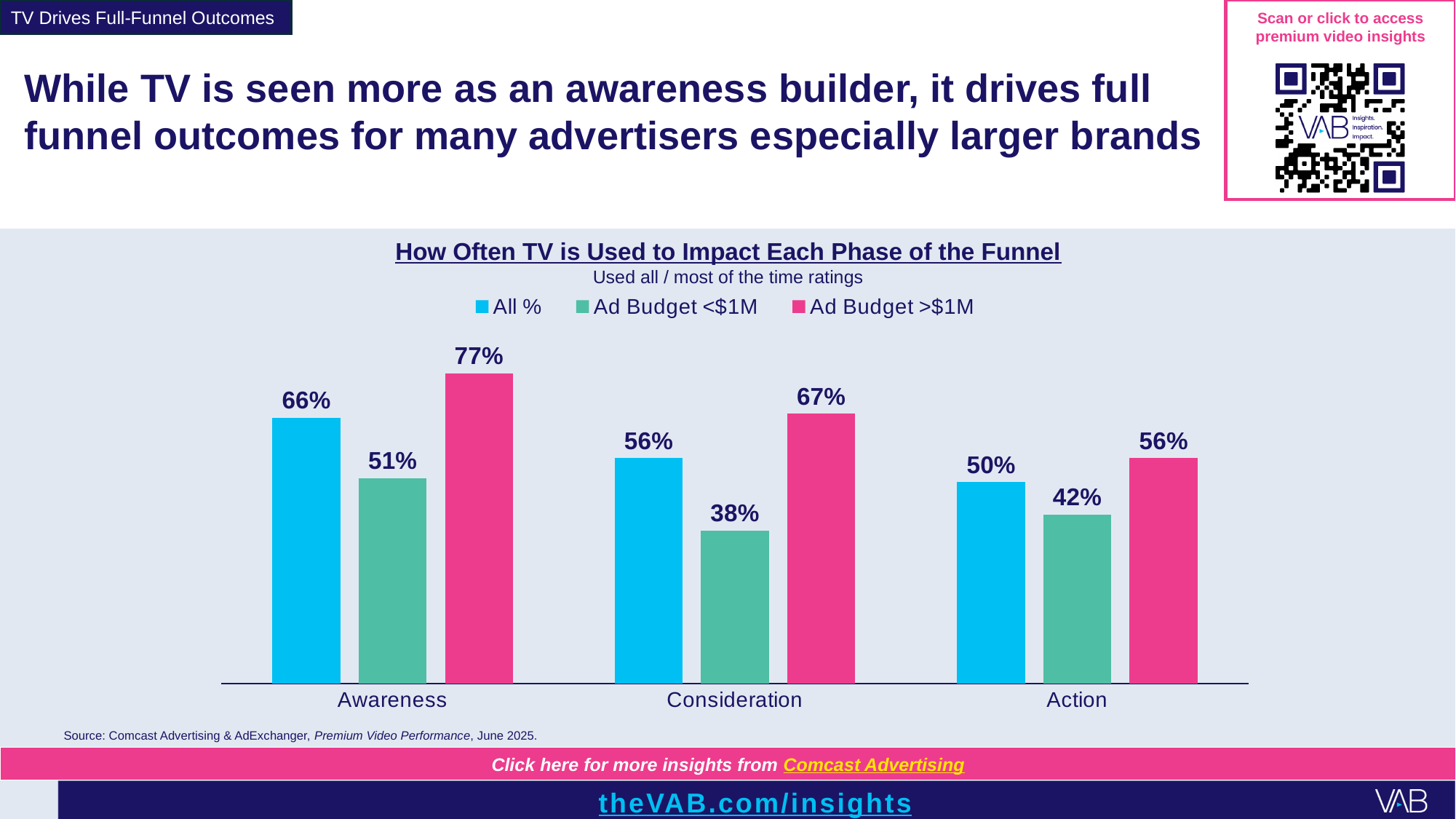
What kind of chart is shown on the slide? Bar chart Which category has the lowest Ad Budget <$1M value? Consideration How many series does the legend list? 3 Which category has the highest All % value? Awareness What is the difference between the Ad Budget >$1M and Ad Budget <$1M values for Consideration? 29% What is the All % value for the Action category? 50% What is the difference between the All % values for Awareness and Action? 16% What is the value for Ad Budget <$1M in the Consideration category? 38% Which is larger for Action: the Ad Budget >$1M value or the Ad Budget <$1M value? Ad Budget >$1M Do the Ad Budget >$1M values rise or fall from Awareness to Action? Fall How many funnel phases (categories) are shown on the x axis? 3 What is the value for Ad Budget >$1M in the Awareness category? 77%